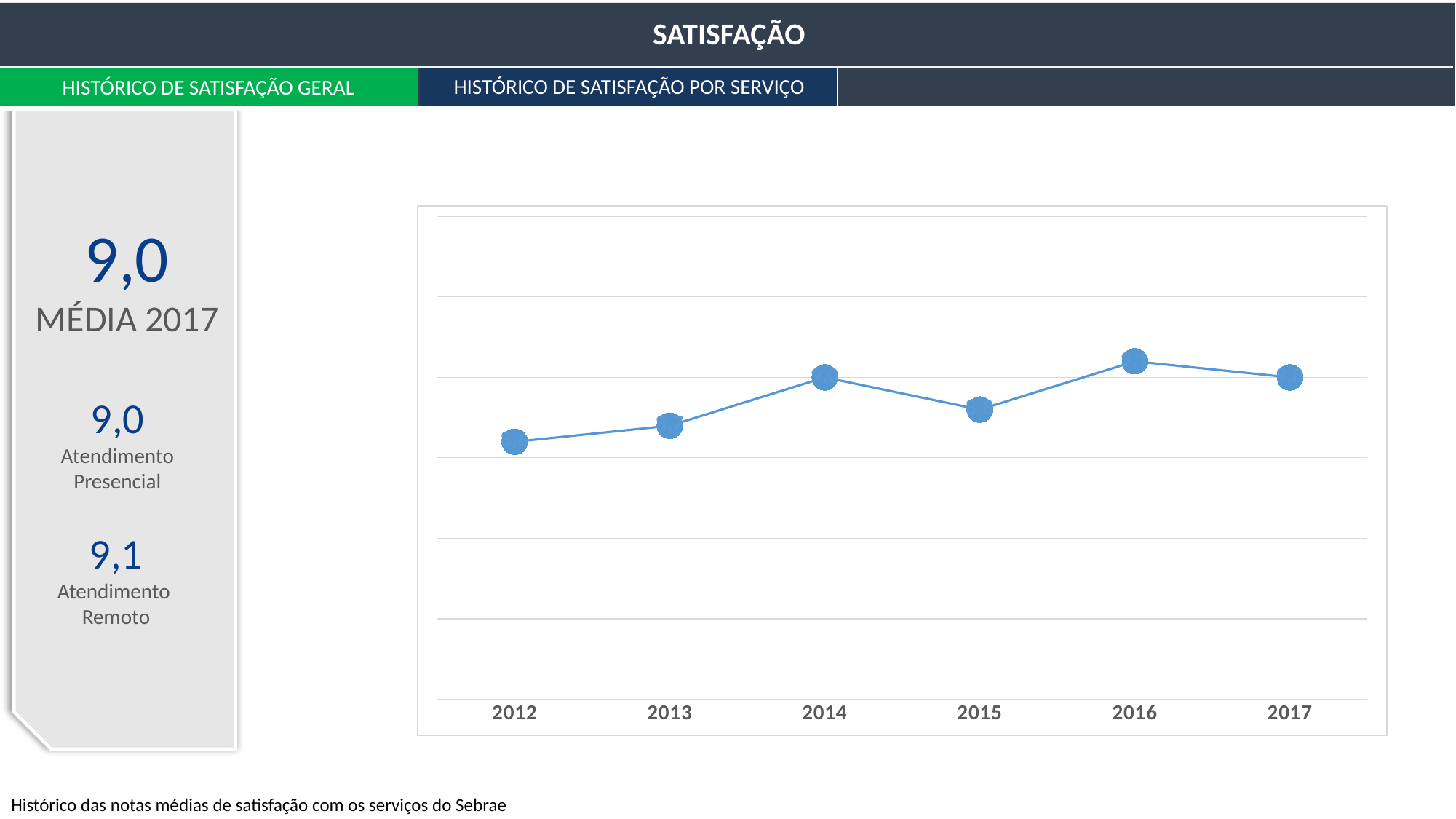
Which year has the lowest value in the chart? 2012 What kind of chart is shown on the slide? line chart How many years are plotted on the x axis of the chart? 6 What is the last year shown on the x axis of the chart? 2017 Which year has the higher value, 2012 or 2013? 2013 What is the first year shown on the x axis of the chart? 2012 Which year has the highest value in the chart? 2016 Do the values rise or fall from 2012 to 2014? rise Which year has the higher value, 2016 or 2017? 2016 Which year has the higher value, 2014 or 2015? 2014 Do the values rise or fall from 2014 to 2015? fall